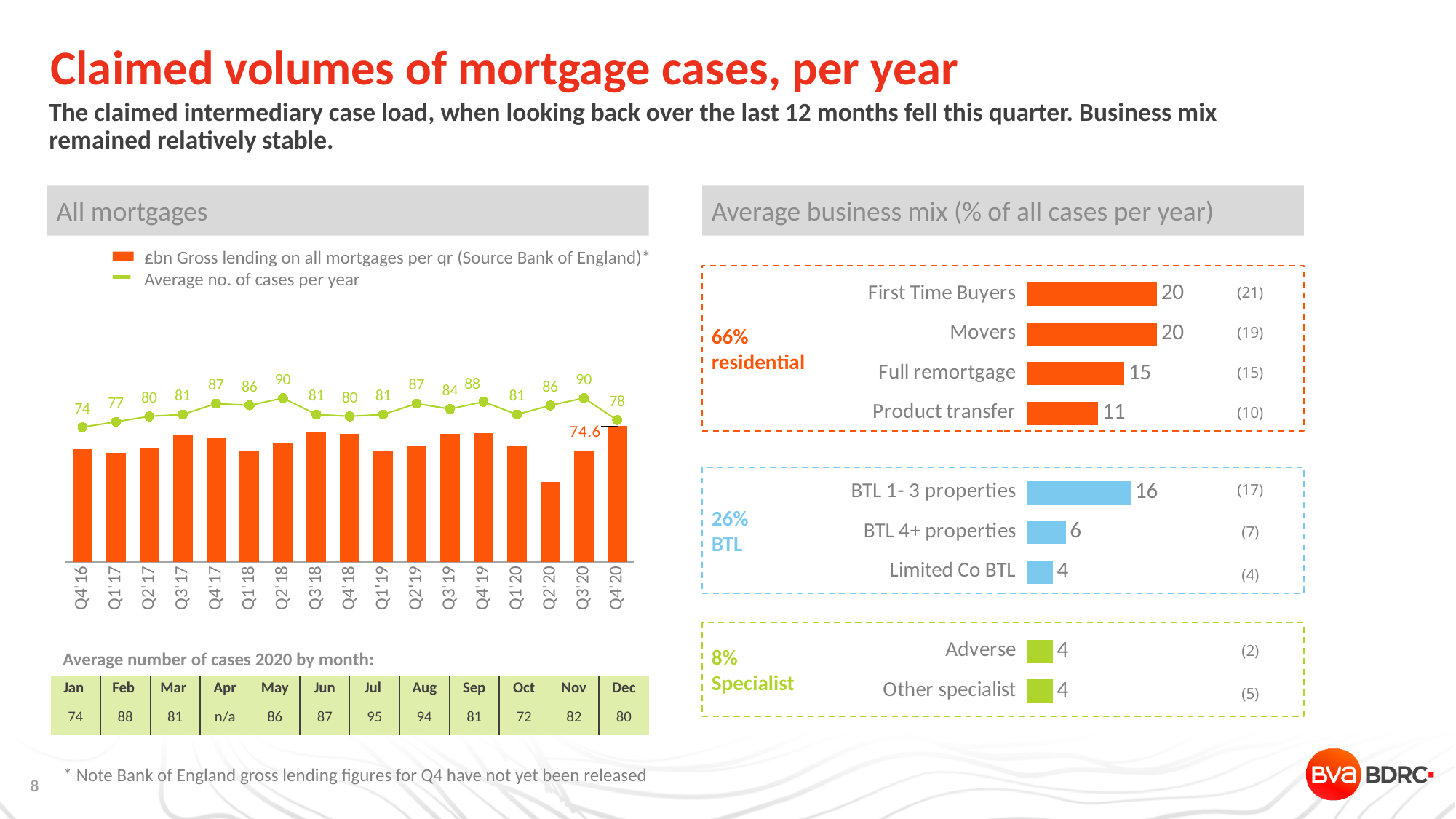
In the All mortgages chart, by how much does the average number of cases per year fall from Q3'20 to Q4'20? 12 How many series does the legend of the All mortgages chart list? 2 In the Average business mix chart, what is the value for Full remortgage? 15 In the Average business mix chart, how many categories are shown? 9 In the All mortgages chart, does the average number of cases per year rise or fall from Q4'16 to Q4'17? Rise In the All mortgages chart, how many quarters are shown on the x axis? 17 In the All mortgages chart, what is the average number of cases per year shown for Q2'18? 90 In the All mortgages chart, what is the average number of cases per year shown for Q4'20? 78 In the Average business mix chart, which is larger: BTL 1- 3 properties or Product transfer? BTL 1- 3 properties In the Average business mix chart, what is the difference between First Time Buyers and Product transfer? 9 What kind of chart is the All mortgages chart? Combined bar and line chart In the All mortgages chart, which quarter has the lowest average number of cases per year? Q4'16